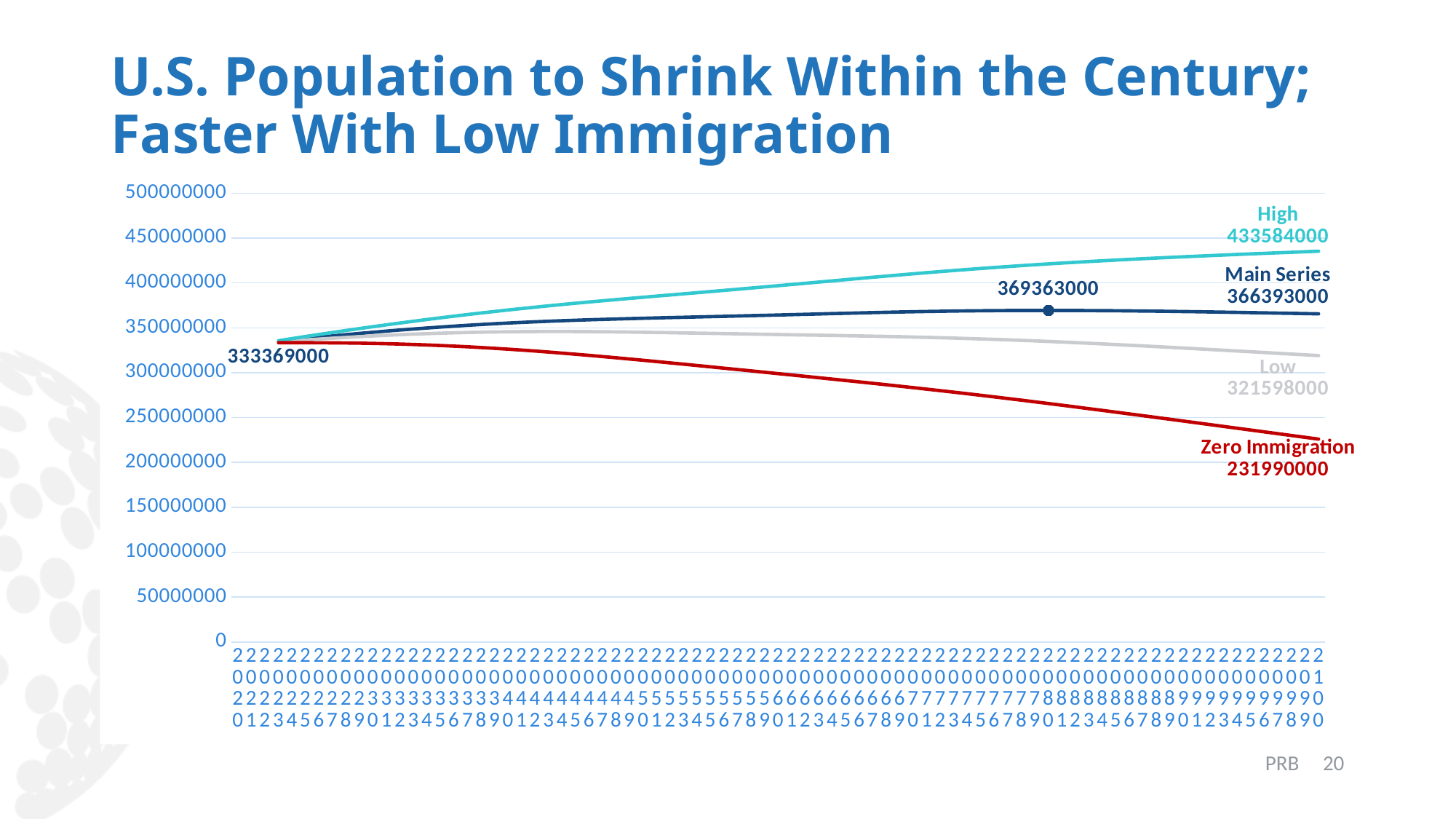
Does the Zero Immigration line rise or fall over the period shown? fall What type of chart is shown on the slide? line chart What value is labeled at the marked peak point on the Main Series line? 369363000 What is the final value labeled for the Low series? 321598000 What is the final value labeled for the Zero Immigration series? 231990000 What is the final value labeled for the Main Series? 366393000 Which series ends at the highest value? High What is the starting value labeled at the left end of the lines? 333369000 Is the final value of the Zero Immigration series greater or less than 250000000? less What is the difference between the final High value and the final Main Series value? 67191000 Which series ends at the lowest value? Zero Immigration What is the final value labeled for the High series? 433584000